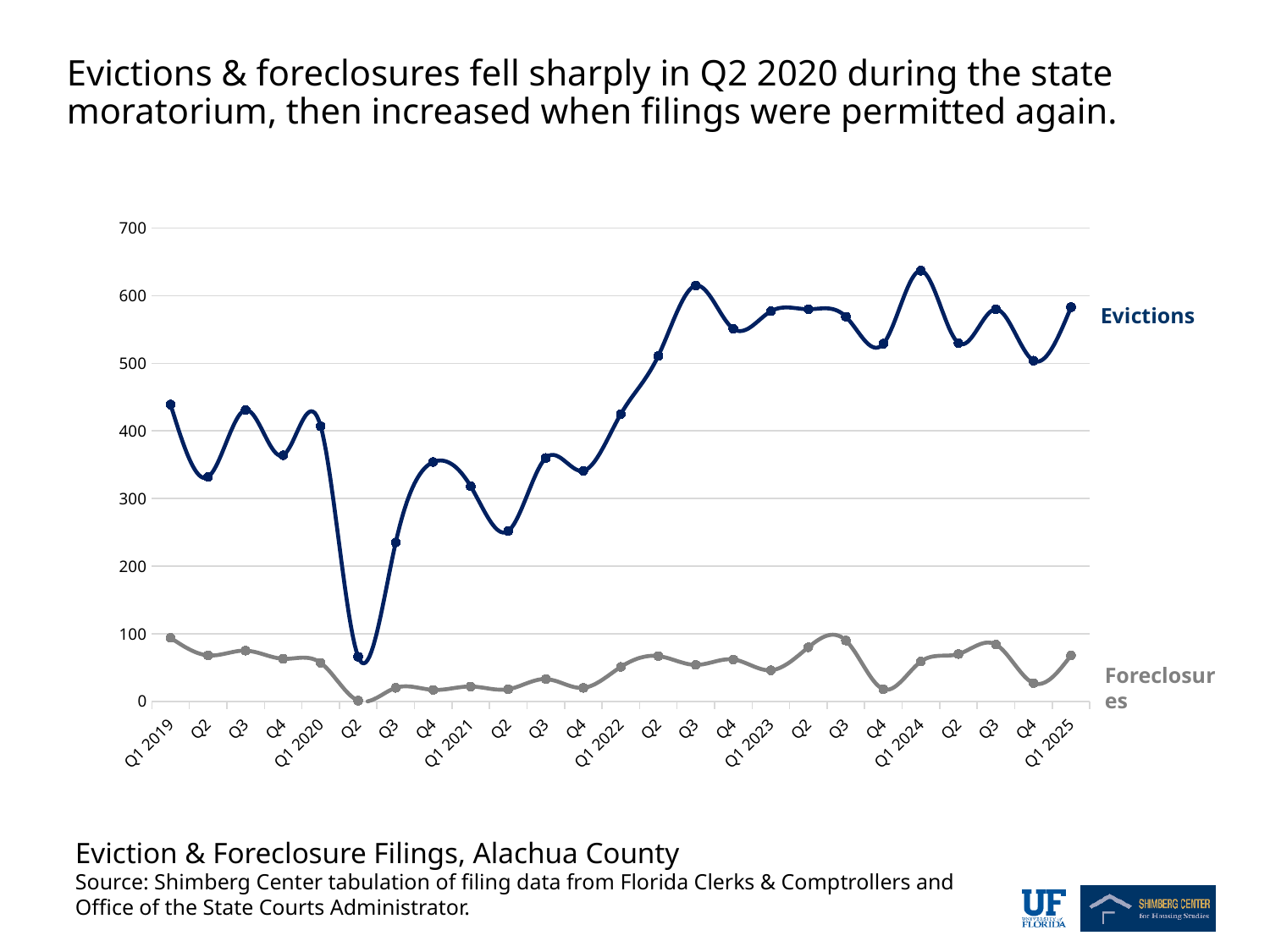
How many series are plotted on the chart? 2 Is the Evictions value for Q1 2019 greater or less than 400? greater What is the title of the chart given below the plot? Eviction & Foreclosure Filings, Alachua County What kind of chart is shown on the slide? line chart In which quarter does the Foreclosures line reach its lowest value? Q2 2020 Do Evictions rise or fall between Q2 2020 and Q3 2022? rise How many quarterly data points does each line have, from Q1 2019 to Q1 2025? 25 In which quarter does the Evictions line reach its lowest value? Q2 2020 Is the Evictions value for Q3 2022 greater or less than 600? greater Which series has the larger value in Q1 2019, Evictions or Foreclosures? Evictions Is the Evictions value for Q2 2020 greater or less than 100? less In which quarter does the Evictions line reach its highest value? Q1 2024